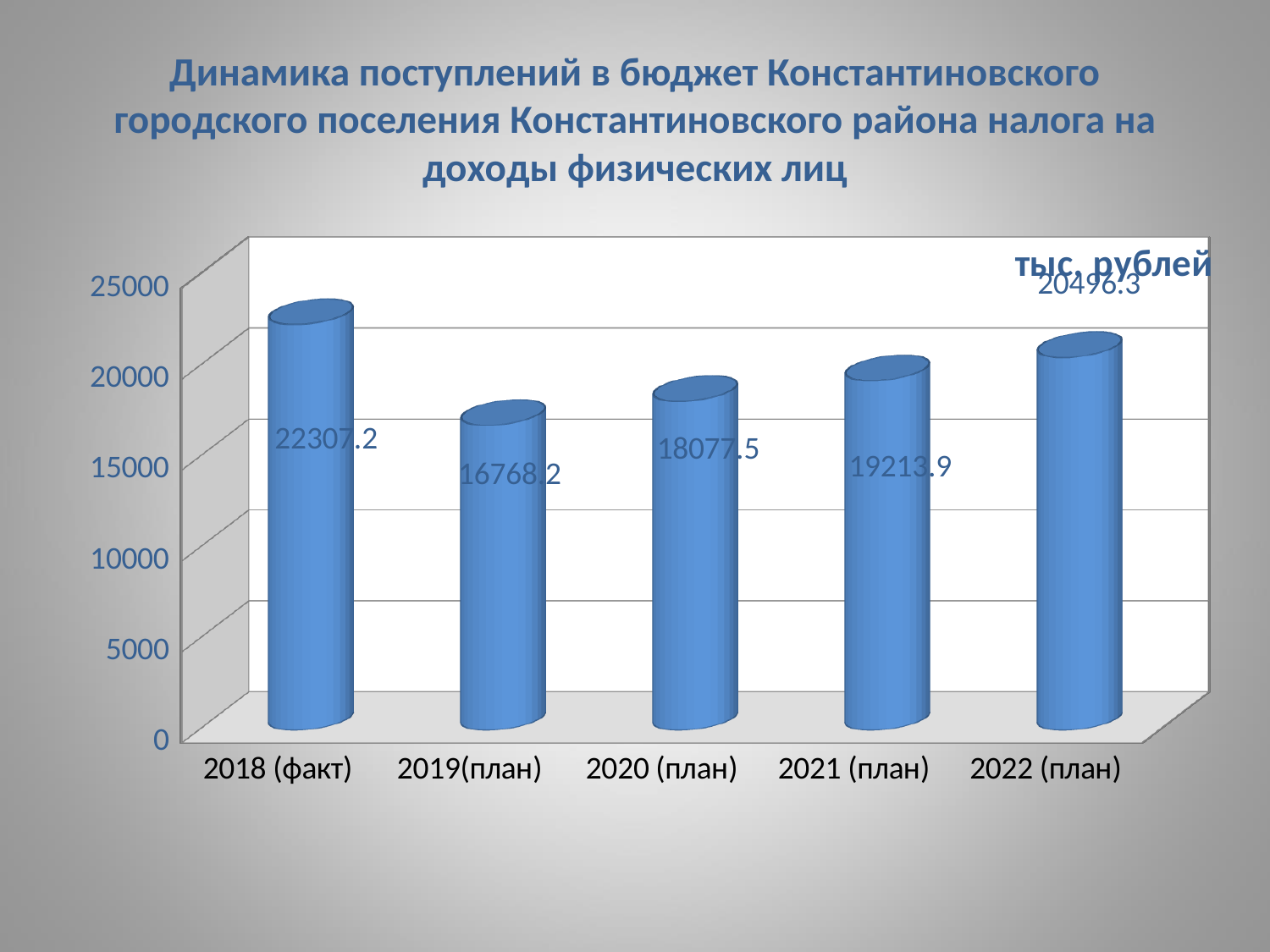
How many categories are shown on the x axis? 5 Which category has the highest value? 2018 (факт) What is the value for 2022 (план)? 20496.3 Which is larger, the value for 2020 (план) or the value for 2021 (план)? 2021 (план) What kind of chart is shown on the slide? bar chart What is the value for 2021 (план)? 19213.9 Which category has the lowest value? 2019(план) What is the difference between the values for 2018 (факт) and 2019(план)? 5539 What is the value for 2018 (факт)? 22307.2 What is the value for 2019(план)? 16768.2 What is the difference between the values for 2022 (план) and 2021 (план)? 1282.4 What unit of measurement is indicated on the chart? тыс. рублей